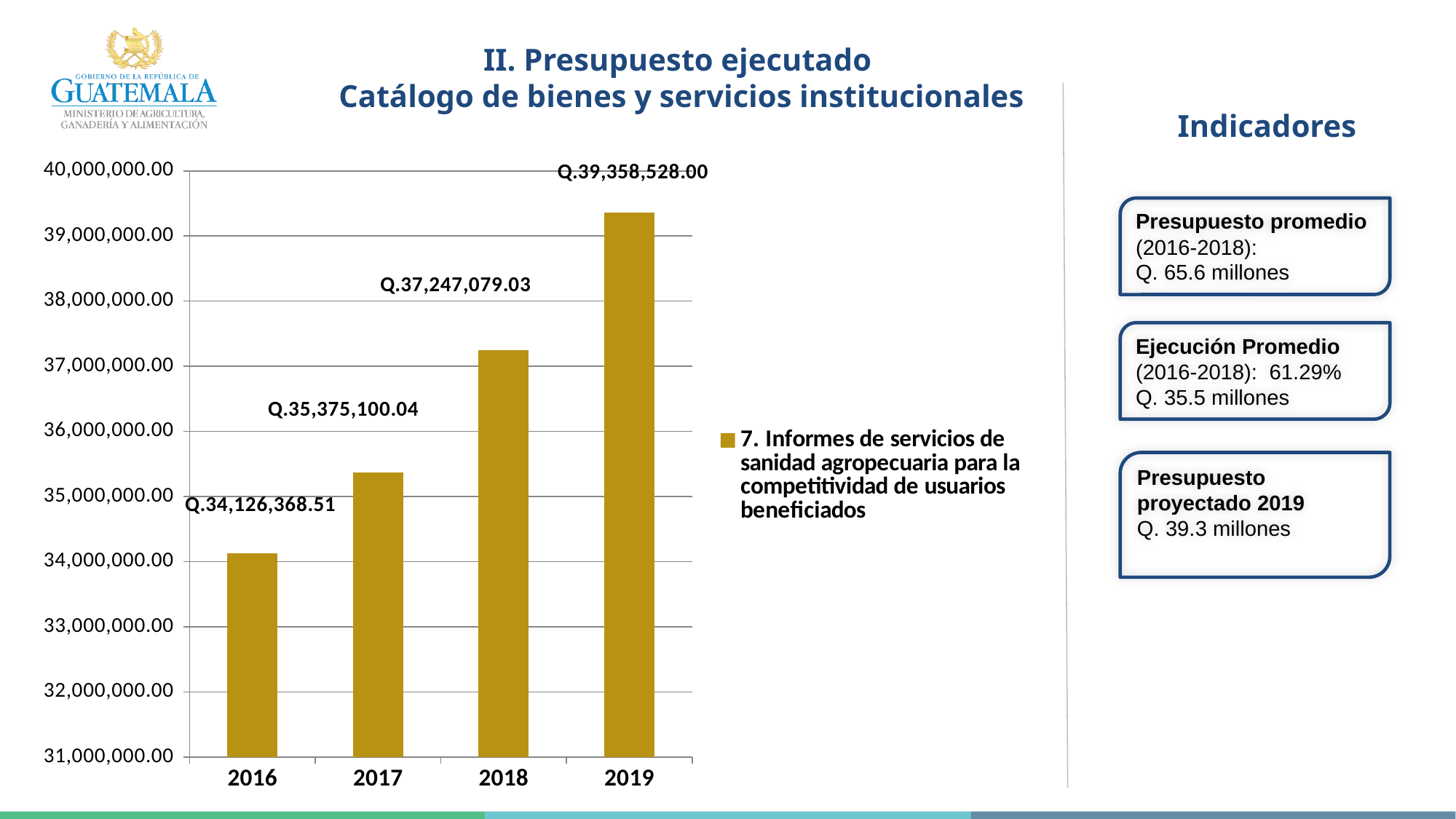
How many years are shown on the x axis? 4 What is the value shown for 2019? Q.39,358,528.00 Which year has the lowest value? 2016 Do the values rise or fall from 2016 to 2019? Rise What kind of chart is shown on the slide? Bar chart Which is larger, the value for 2017 or the value for 2018? 2018 What is the value shown for 2016? Q.34,126,368.51 What is the difference between the 2019 value and the 2016 value? Q.5,232,159.49 Which year has the highest value? 2019 What is the difference between the 2018 value and the 2017 value? Q.1,871,978.99 Is the value for 2017 greater or less than 36,000,000.00? less What is the value shown for 2018? Q.37,247,079.03